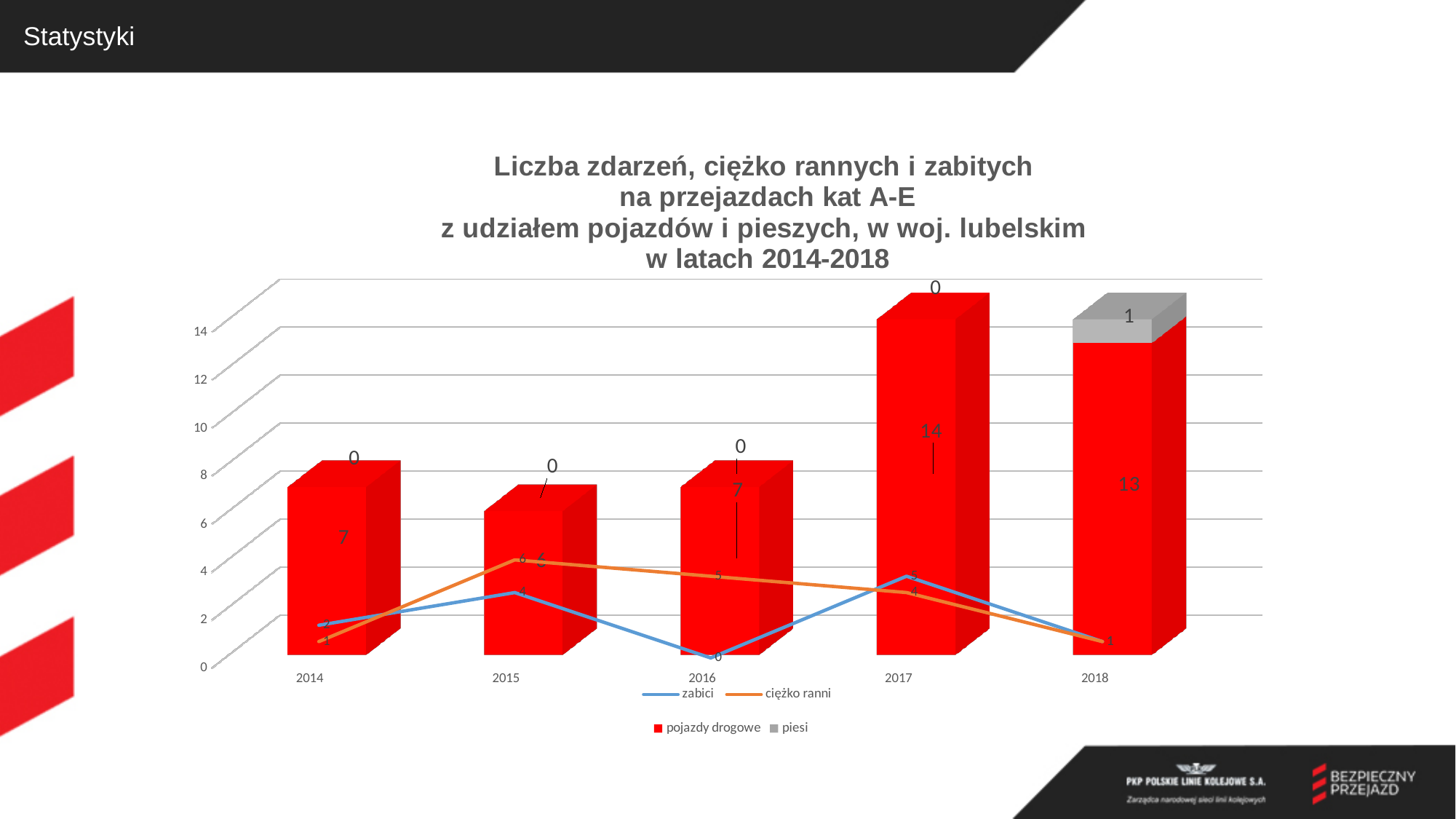
What is the total of the stacked bar for 2018 (pojazdy drogowe plus piesi)? 14 How many series does the legend list? 4 Which is larger, the pojazdy drogowe value for 2016 or for 2017? 2017 Which year has the highest value for pojazdy drogowe? 2017 What is the value for pojazdy drogowe in 2014? 7 What is the value for pojazdy drogowe in 2017? 14 Does the pojazdy drogowe value rise or fall from 2016 to 2017? rise What is the value for piesi in 2018? 1 What is the difference between the pojazdy drogowe values for 2017 and 2018? 1 How many years are shown on the x axis? 5 What is the value for zabici in 2016? 0 What is the value for pojazdy drogowe in 2018? 13